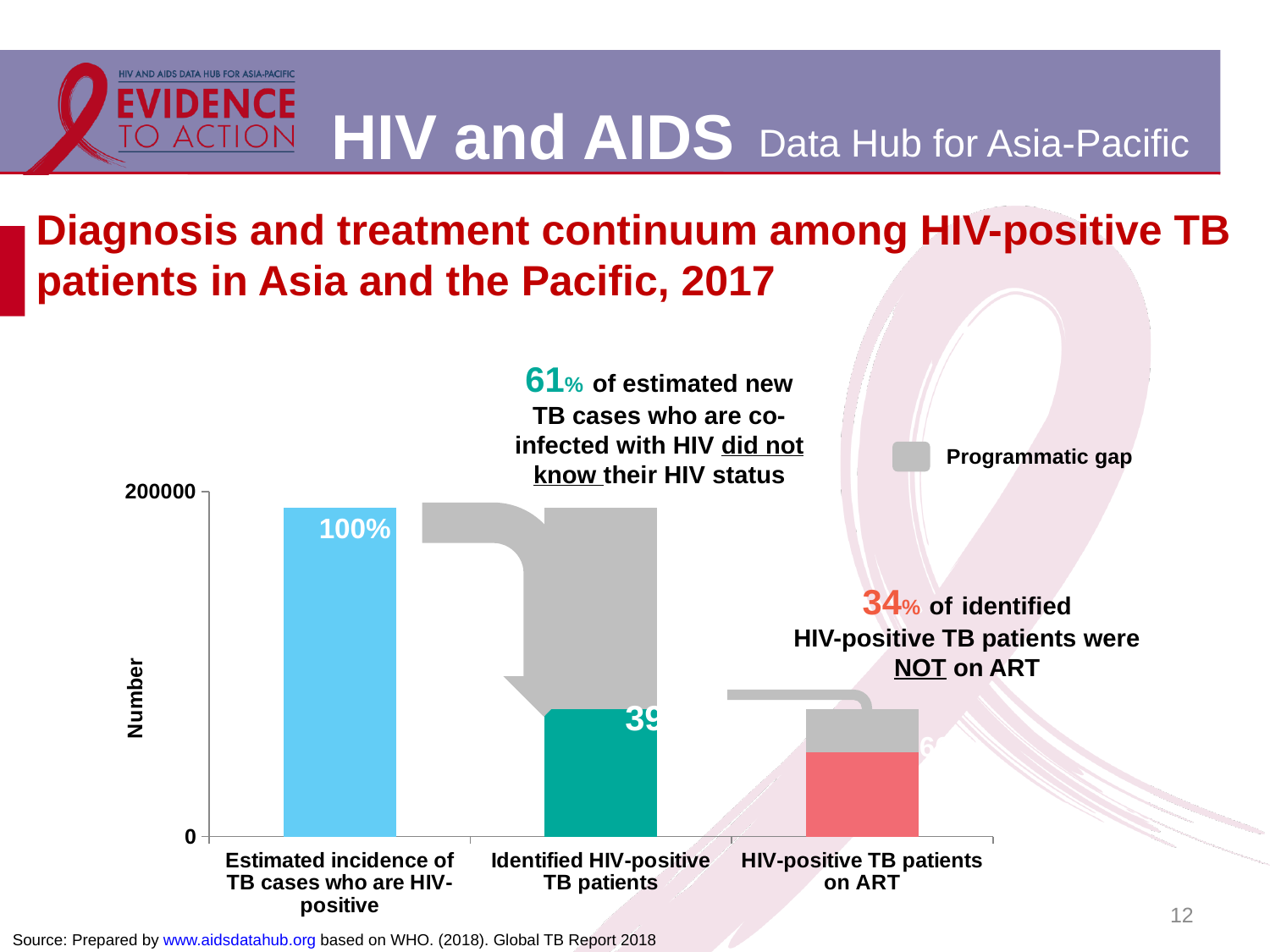
What is the title of the y axis of the chart? Number What percentage label is shown on the bar for 'Estimated incidence of TB cases who are HIV-positive'? 100% Do the bar values rise or fall moving from left to right along the x axis? fall How many categories are shown on the x axis of the chart? 3 According to the annotation on the chart, what percentage of estimated new TB cases co-infected with HIV did not know their HIV status? 61% What type of chart is shown on the slide? bar chart Which bar is taller: 'Identified HIV-positive TB patients' or 'HIV-positive TB patients on ART'? Identified HIV-positive TB patients Is the value for 'Estimated incidence of TB cases who are HIV-positive' greater or less than 200000? less Which category has the highest bar in the chart? Estimated incidence of TB cases who are HIV-positive Which category has the lowest bar in the chart? HIV-positive TB patients on ART